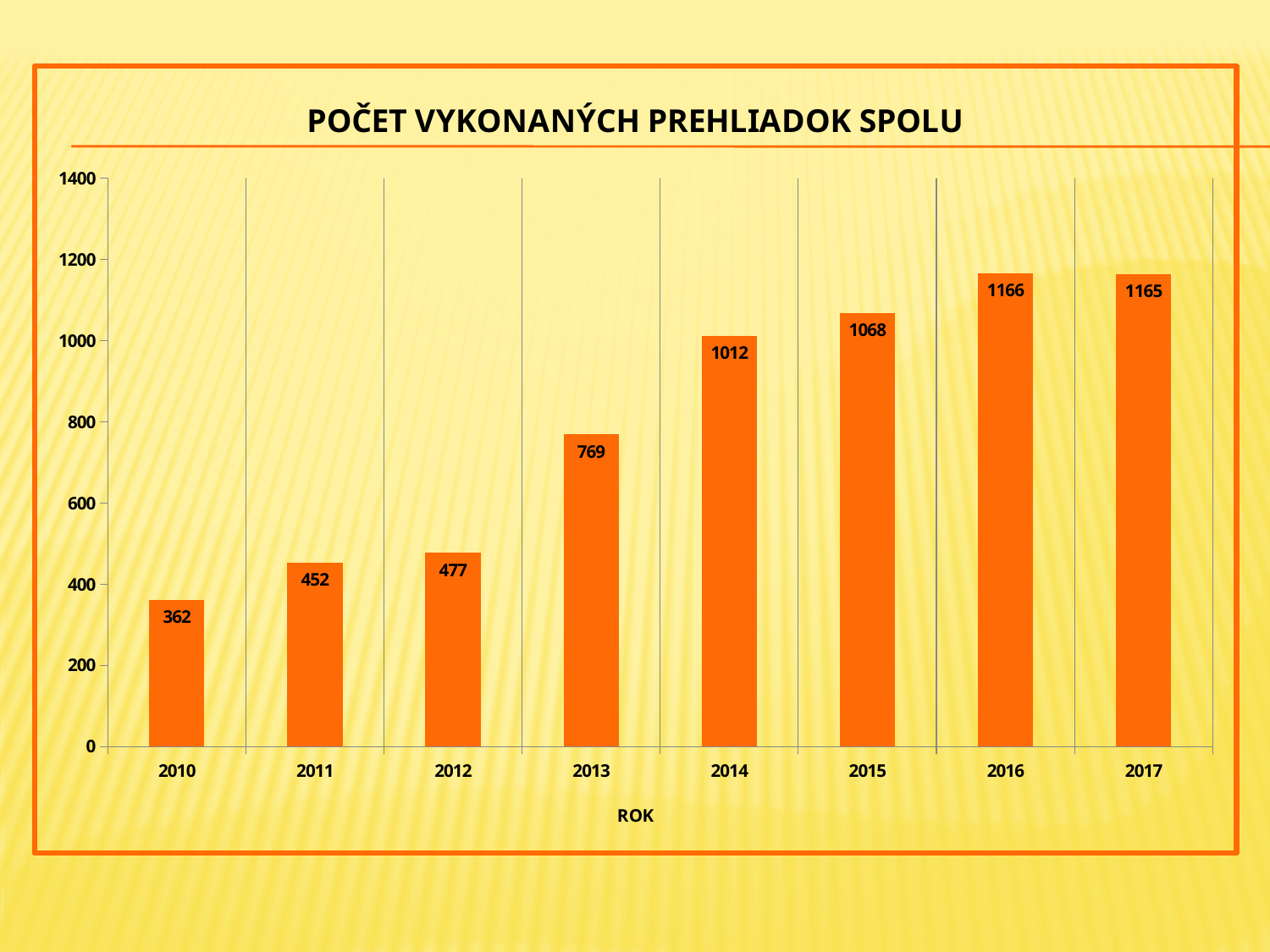
Which year has the highest value? 2016 What kind of chart is shown on the slide? bar chart What is the value for 2013? 769 What is the value for 2010? 362 Is the value for 2013 greater or less than 800? less What is the difference between the values for 2012 and 2011? 25 Which is larger, the value for 2014 or the value for 2012? 2014 Which year has the lowest value? 2010 How many years are shown on the x axis? 8 What is the title of the chart? POČET VYKONANÝCH PREHLIADOK SPOLU What is the value for 2015? 1068 What is the difference between the values for 2014 and 2013? 243